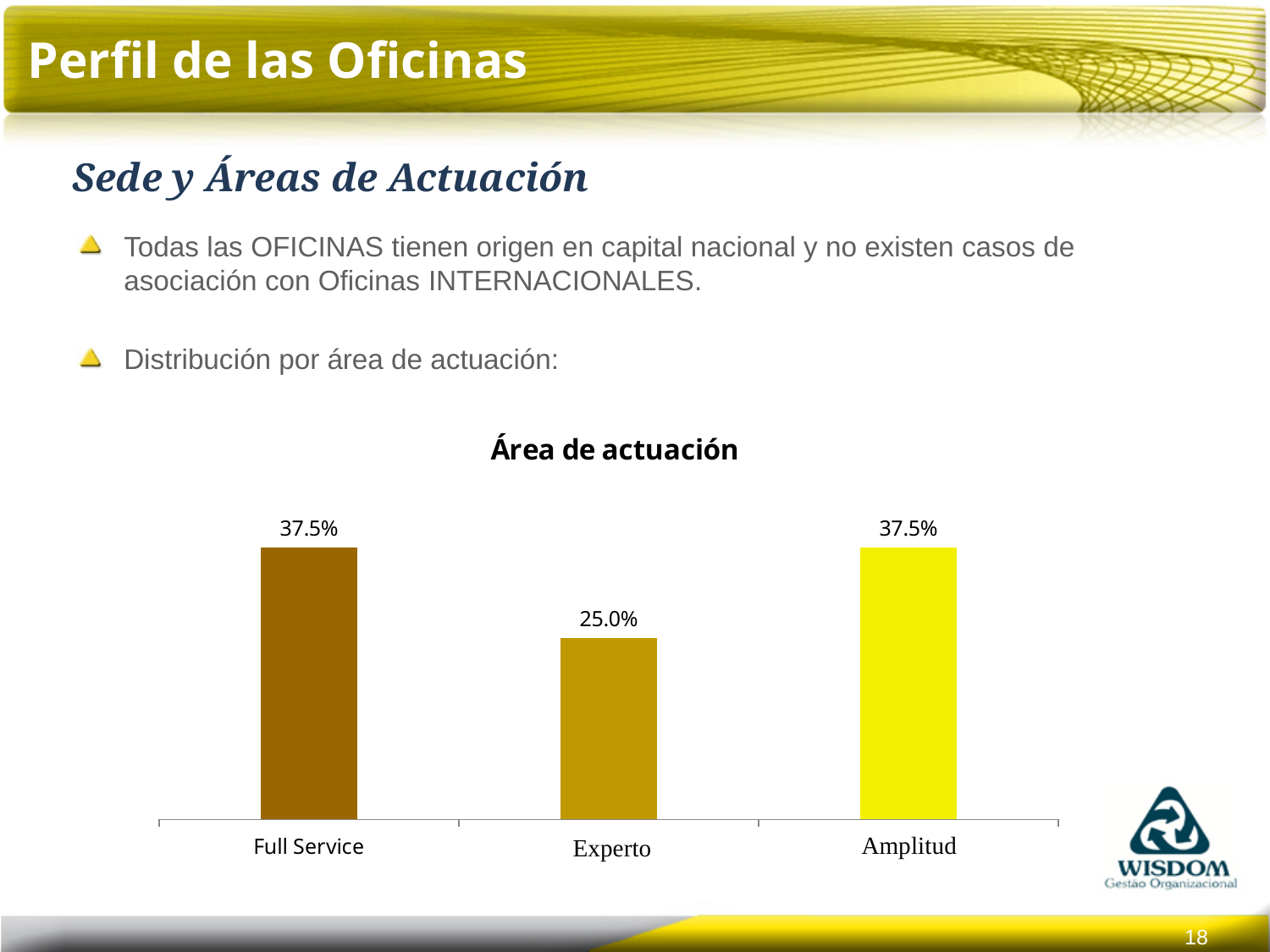
What is the difference between the values for Amplitud and Experto? 12.5% Which is larger, the value for Full Service or the value for Experto? Full Service What is the difference between the values for Full Service and Experto? 12.5% How many categories are shown in the Área de actuación chart? 3 Which is larger, the value for Experto or the value for Amplitud? Amplitud What is the value for Experto in the Área de actuación chart? 25.0% What is the title of the chart on the slide? Área de actuación Which category has the lowest value in the Área de actuación chart? Experto What is the total of the three values shown in the Área de actuación chart? 100.0% What kind of chart is shown on the slide? Bar chart What is the value for Amplitud in the Área de actuación chart? 37.5% What is the value for Full Service in the Área de actuación chart? 37.5%